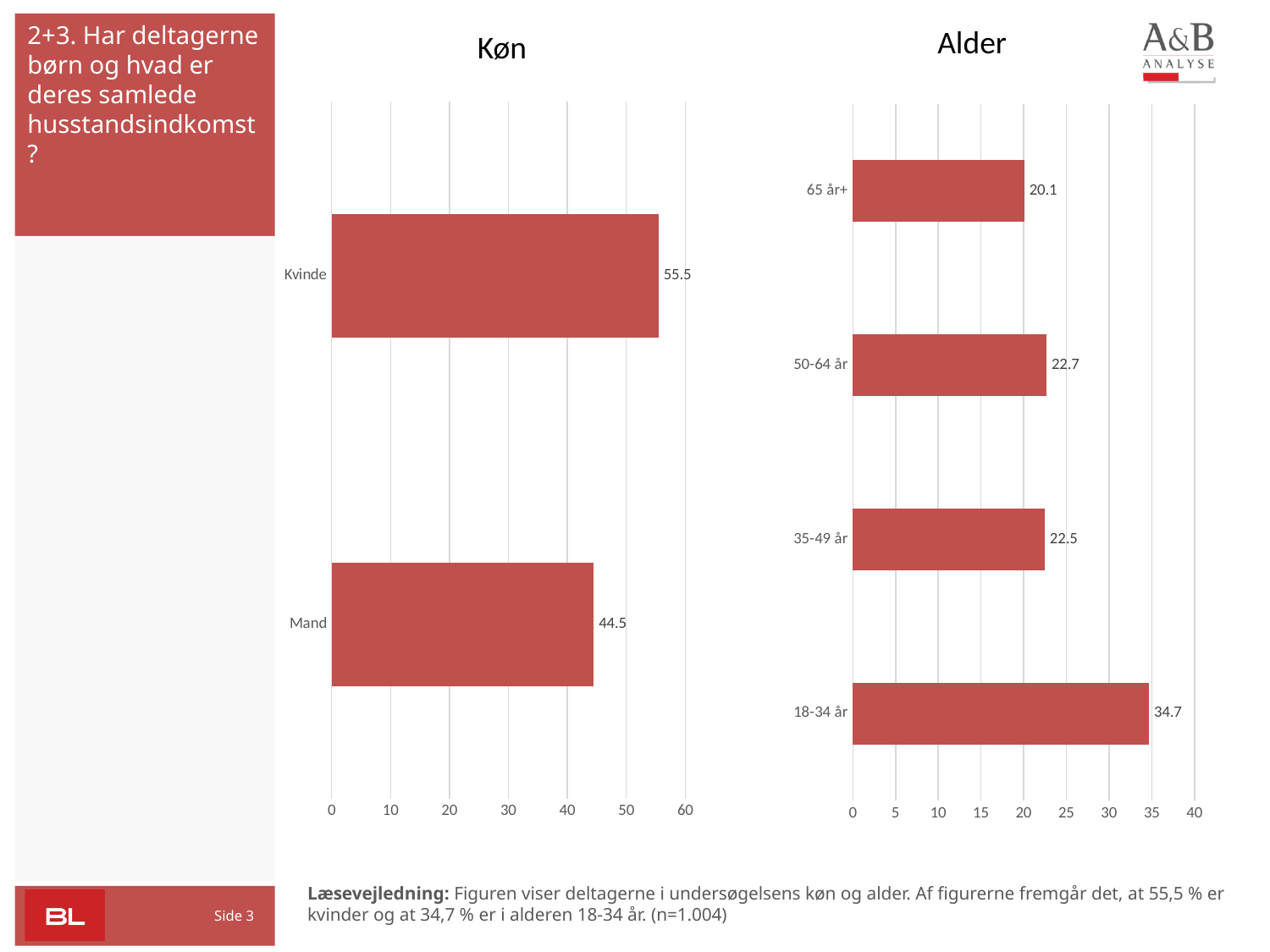
In the Køn chart, what is the value for Kvinde? 55.5 What kind of chart is the Alder chart? Bar chart In the Alder chart, which age group has the lowest value? 65 år+ In the Alder chart, what is the value for 18-34 år? 34.7 In the Alder chart, is the value for 35-49 år greater or less than 20? greater In the Køn chart, what is the difference between the values for Kvinde and Mand? 11.0 In the Køn chart, what is the value for Mand? 44.5 In the Køn chart, which category has the higher value, Kvinde or Mand? Kvinde In the Alder chart, what is the value for 65 år+? 20.1 In the Alder chart, what is the difference between the values for 18-34 år and 50-64 år? 12.0 In the Alder chart, how many age groups are shown? 4 In the Alder chart, which age group has the highest value? 18-34 år